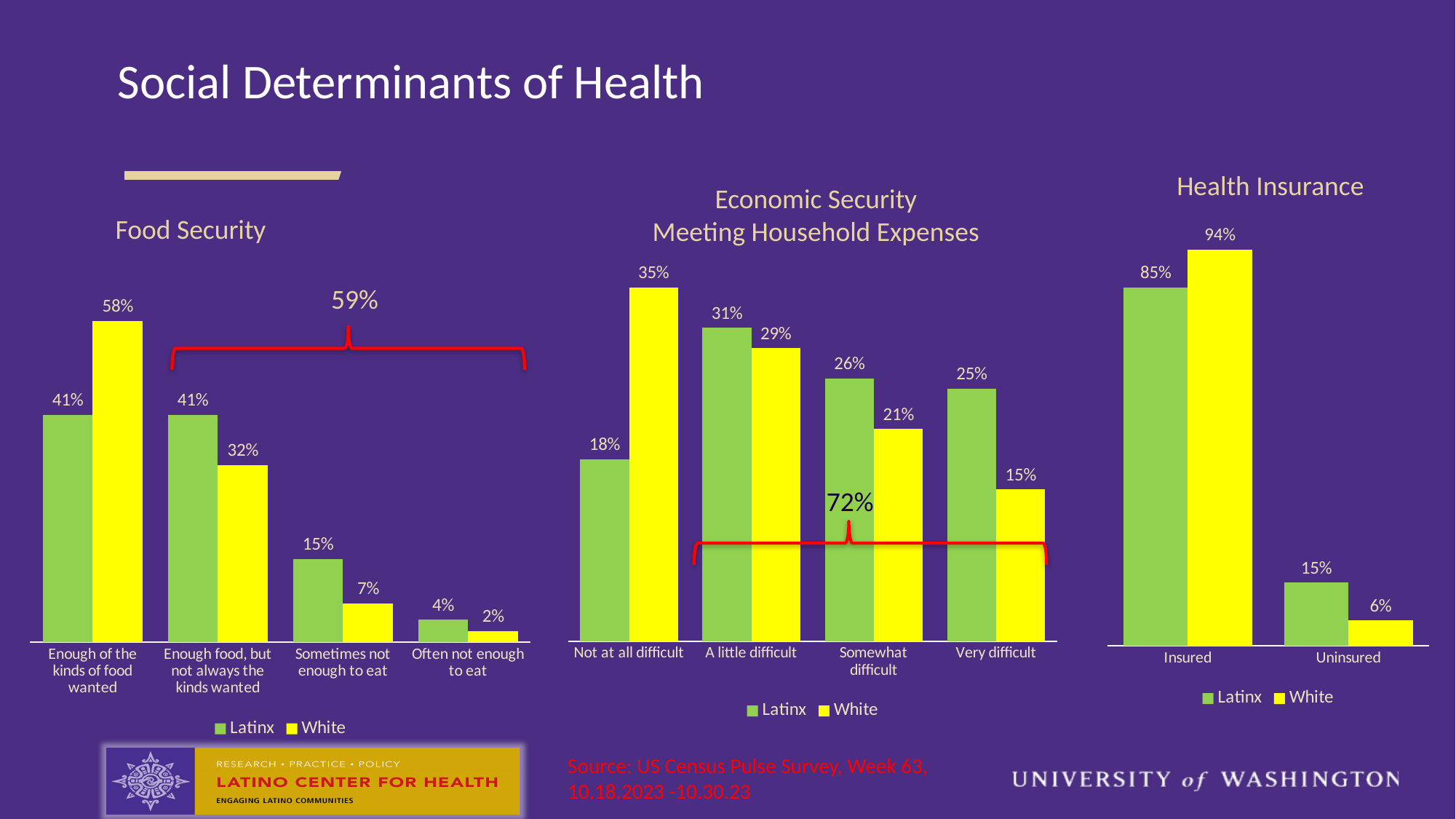
In the Food Security chart, what is the difference between the Latinx and White values for 'Enough food, but not always the kinds wanted'? 9% In the Health Insurance chart, what is the value for White in the 'Insured' category? 94% In the Economic Security Meeting Household Expenses chart, what is the difference between the Latinx and White values for 'Somewhat difficult'? 5% In the Food Security chart, what is the value for Latinx in the 'Sometimes not enough to eat' category? 15% How many categories are shown on the x axis of the Economic Security Meeting Household Expenses chart? 4 In the Food Security chart, what is the value for White in the 'Enough of the kinds of food wanted' category? 58% How many series does the legend of the Health Insurance chart list? 2 In the Economic Security Meeting Household Expenses chart, what is the value for White in the 'Not at all difficult' category? 35% In the Food Security chart, which category has the lowest White value? Often not enough to eat In the Economic Security Meeting Household Expenses chart, is the Latinx value or the White value larger for 'Very difficult'? Latinx In the Health Insurance chart, what is the difference between the Latinx and White values for 'Uninsured'? 9% In the Economic Security Meeting Household Expenses chart, which category has the highest Latinx value? A little difficult